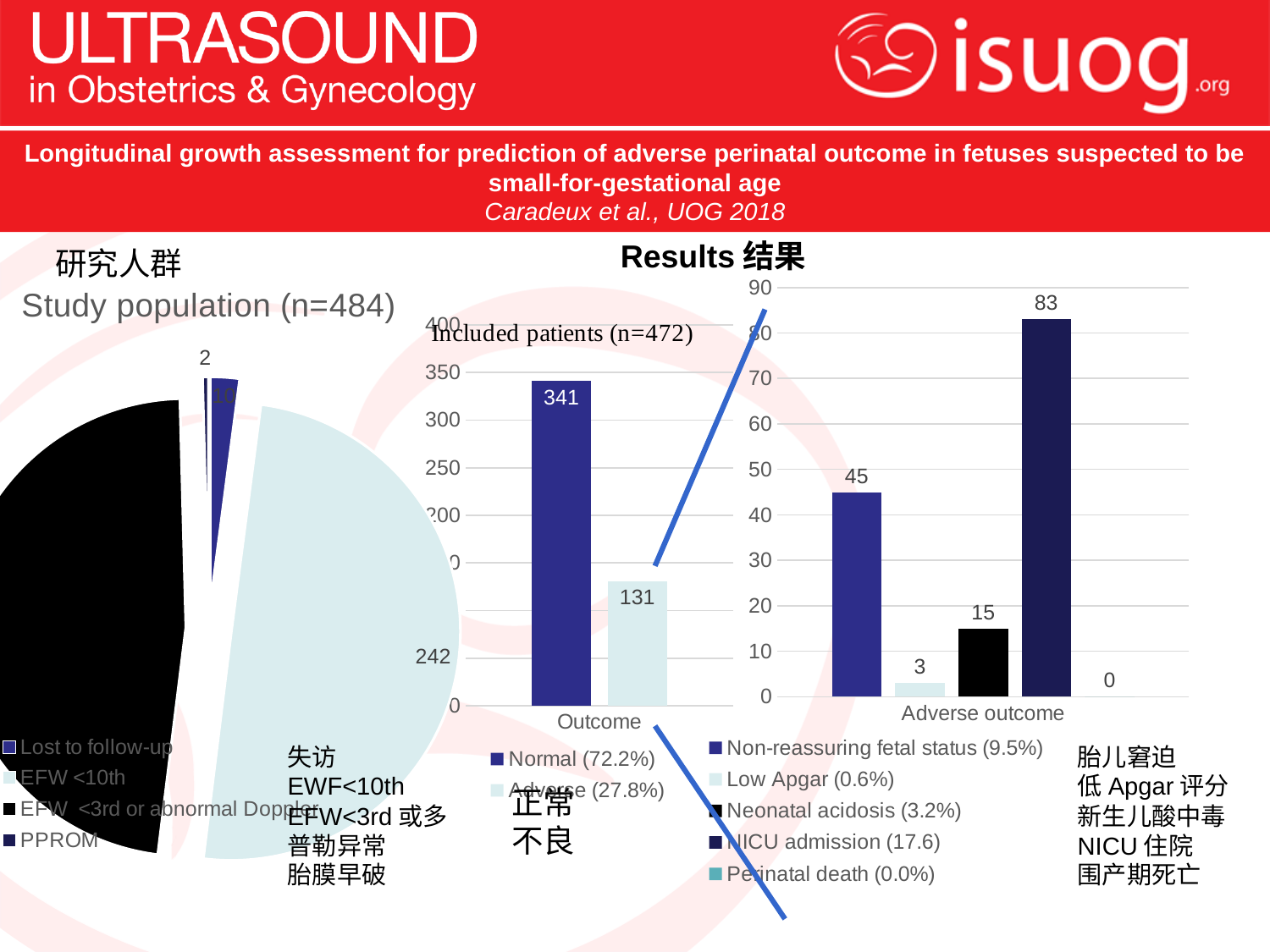
In the 'Adverse outcome' bar chart, what is the difference between NICU admission and Non-reassuring fetal status? 38 In the 'Adverse outcome' bar chart, how many series does the legend list? 5 In the 'Adverse outcome' bar chart, which category has the highest value? NICU admission In the 'Adverse outcome' bar chart, which is larger: Neonatal acidosis or Low Apgar? Neonatal acidosis In the 'Adverse outcome' bar chart, what is the value for Non-reassuring fetal status? 45 In the 'Included patients (n=472)' bar chart, what is the value for Adverse? 131 In the 'Adverse outcome' bar chart, what is the value for NICU admission? 83 In the 'Adverse outcome' bar chart, which category has the lowest value? Perinatal death In the 'Included patients (n=472)' bar chart, what is the difference between the Normal and Adverse values? 210 What kind of chart is the 'Study population (n=484)' chart on the left? Pie chart In the 'Included patients (n=472)' bar chart, what is the value for Normal? 341 In the 'Included patients (n=472)' bar chart, what percentage does the legend give for Adverse? 27.8%